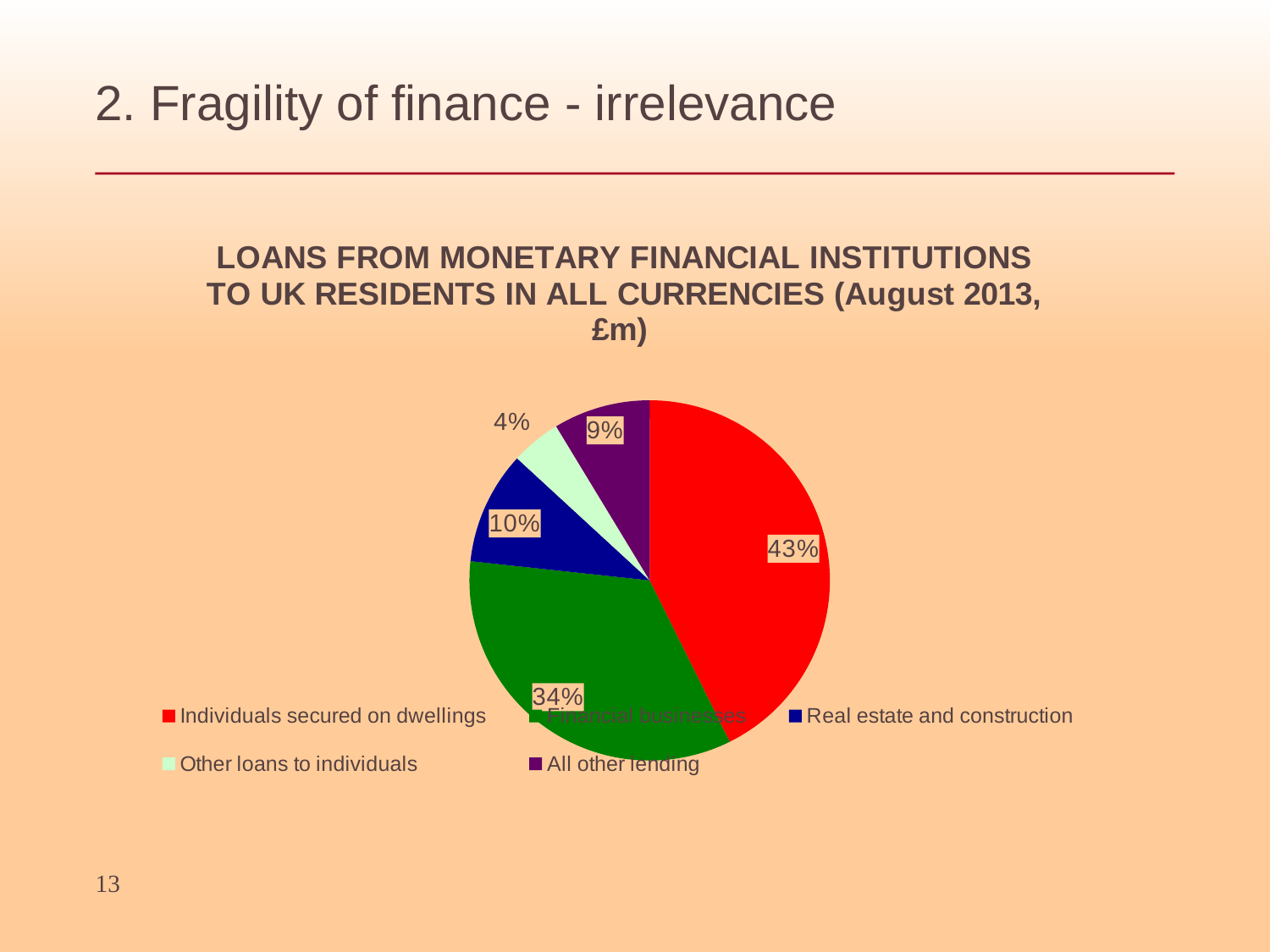
What colour is the slice for All other lending? purple Which category has the smallest share of the pie? Other loans to individuals What share of the pie is Individuals secured on dwellings? 43% What kind of chart is shown on the slide? pie chart What share of the pie is Financial businesses? 34% Which category has the largest share of the pie? Individuals secured on dwellings What share of the pie is Real estate and construction? 10% Which is larger, the share for Real estate and construction or the share for All other lending? Real estate and construction How many slices does the pie chart have? 5 What is the difference in percentage points between Individuals secured on dwellings and Financial businesses? 9